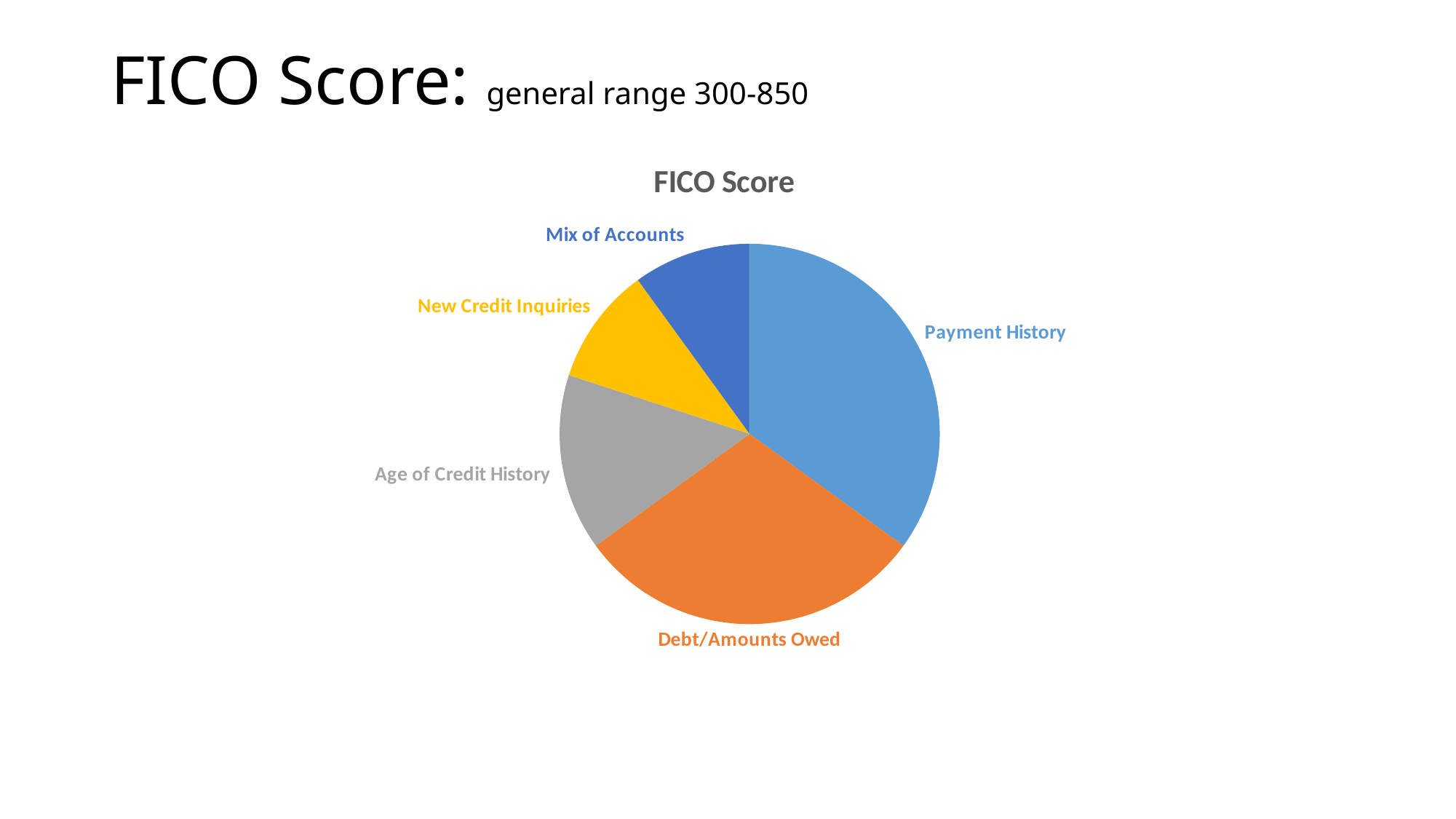
What kind of chart is shown on the slide? Pie chart What is the title of the chart? FICO Score Which slice is larger, Payment History or Age of Credit History? Payment History Which slice is larger, Age of Credit History or Mix of Accounts? Age of Credit History Which slice is larger, Debt/Amounts Owed or New Credit Inquiries? Debt/Amounts Owed How many slices does the pie chart have? 5 What colour is the Debt/Amounts Owed slice? Orange Which category has the largest slice of the pie chart? Payment History